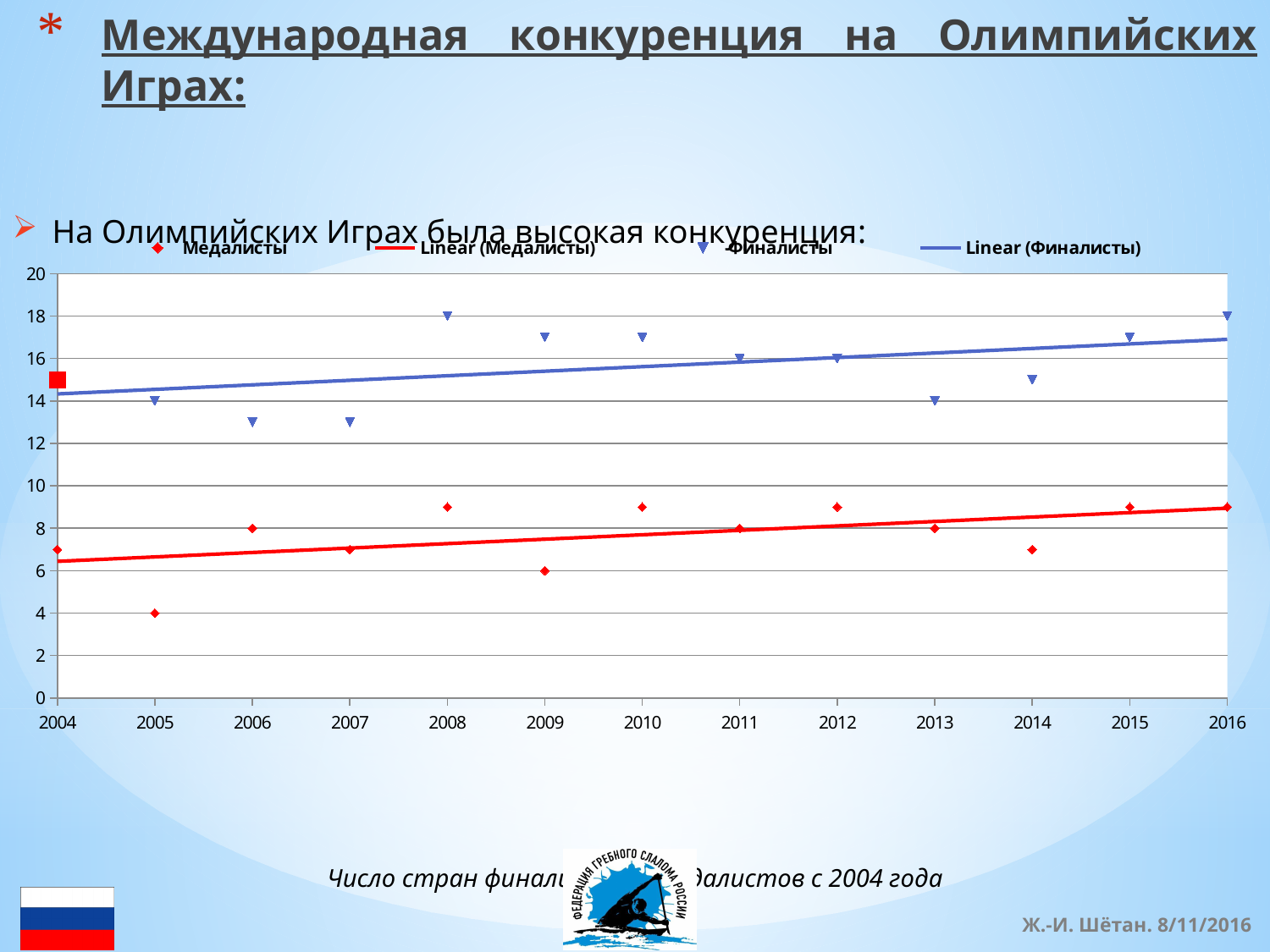
How many entries does the chart legend list? 4 Which is larger, the Финалисты value in 2008 or in 2005? 2008 Is the value for Медалисты in 2012 greater or less than 8? greater In which year is the Медалисты value lowest? 2005 Is the value for Финалисты in 2009 greater or less than 16? greater What is the value for Медалисты in 2009? 6 Does the Linear (Медалисты) trendline rise or fall from 2004 to 2016? rises What is the difference between the Финалисты value in 2008 and in 2005? 4 How many years are shown along the x axis of the chart? 13 What kind of chart is shown on the slide? scatter chart What is the value for Финалисты in 2008? 18 What is the value for Медалисты in 2005? 4